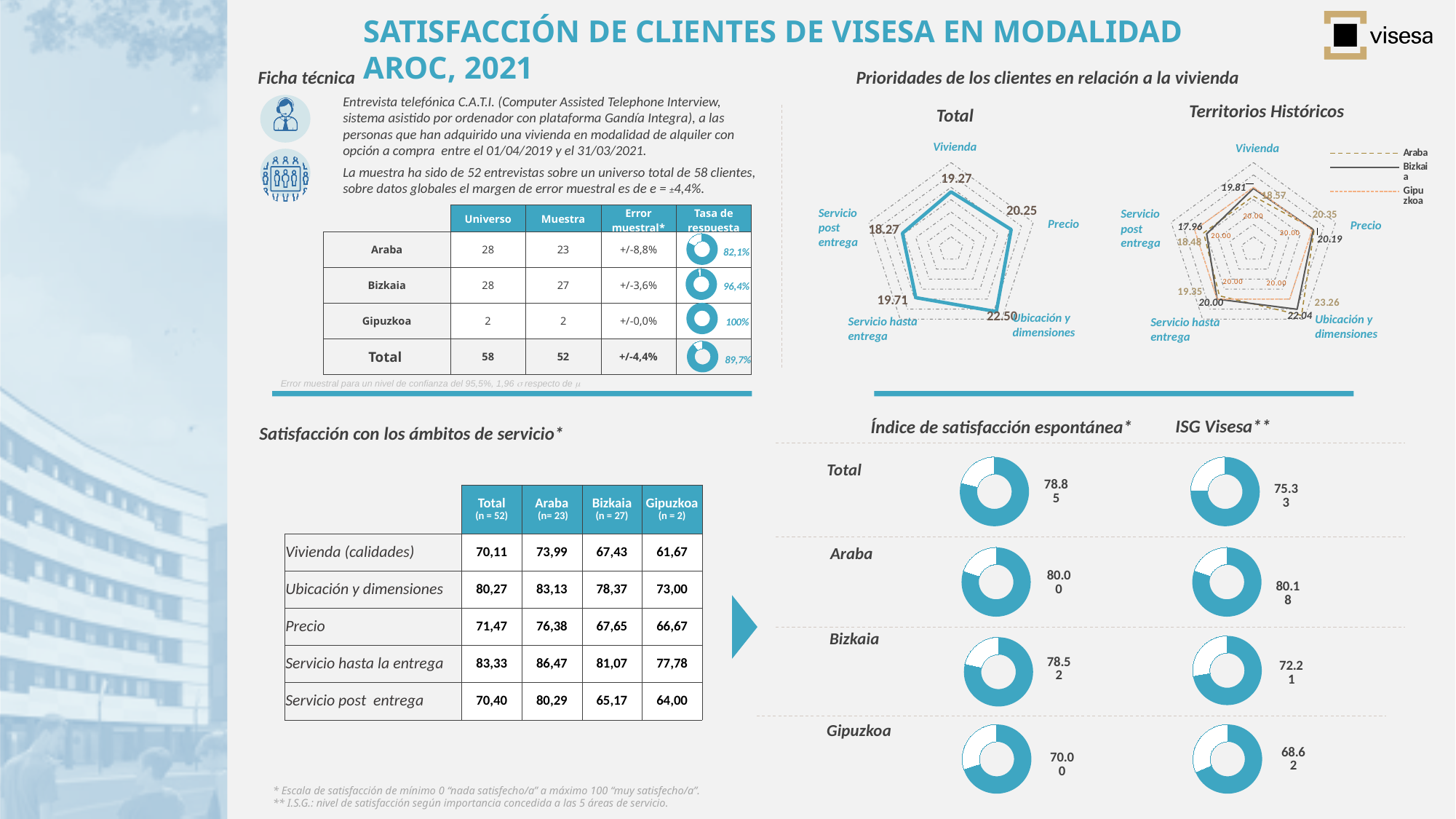
How many dimensions (axes) does the 'Total' radar chart have? 5 In the 'Total' radar chart, which dimension has the highest value? Ubicación y dimensiones In the 'Total' radar chart, which dimension has the lowest value? Servicio post entrega In the 'Total' radar chart under 'Prioridades de los clientes en relación a la vivienda', what is the value for Ubicación y dimensiones? 22.50 What kind of chart is the 'Total' chart under 'Prioridades de los clientes en relación a la vivienda'? Radar chart In the 'Total' radar chart, what is the difference between the value for Precio and the value for Vivienda? 0.98 Among the 'ISG Visesa' donut charts, which territory has the lowest value? Gipuzkoa How many series does the legend of the 'Territorios Históricos' radar chart list? 3 In the 'Índice de satisfacción espontánea' donut charts, what is the value for Gipuzkoa? 70.00 For Total, which is larger: the 'Índice de satisfacción espontánea' value or the 'ISG Visesa' value? Índice de satisfacción espontánea (78.85) In the 'Tasa de respuesta' donut charts of the Ficha técnica table, what is the response rate for Bizkaia? 96,4% In the 'ISG Visesa' donut charts, what is the value for Araba? 80.18